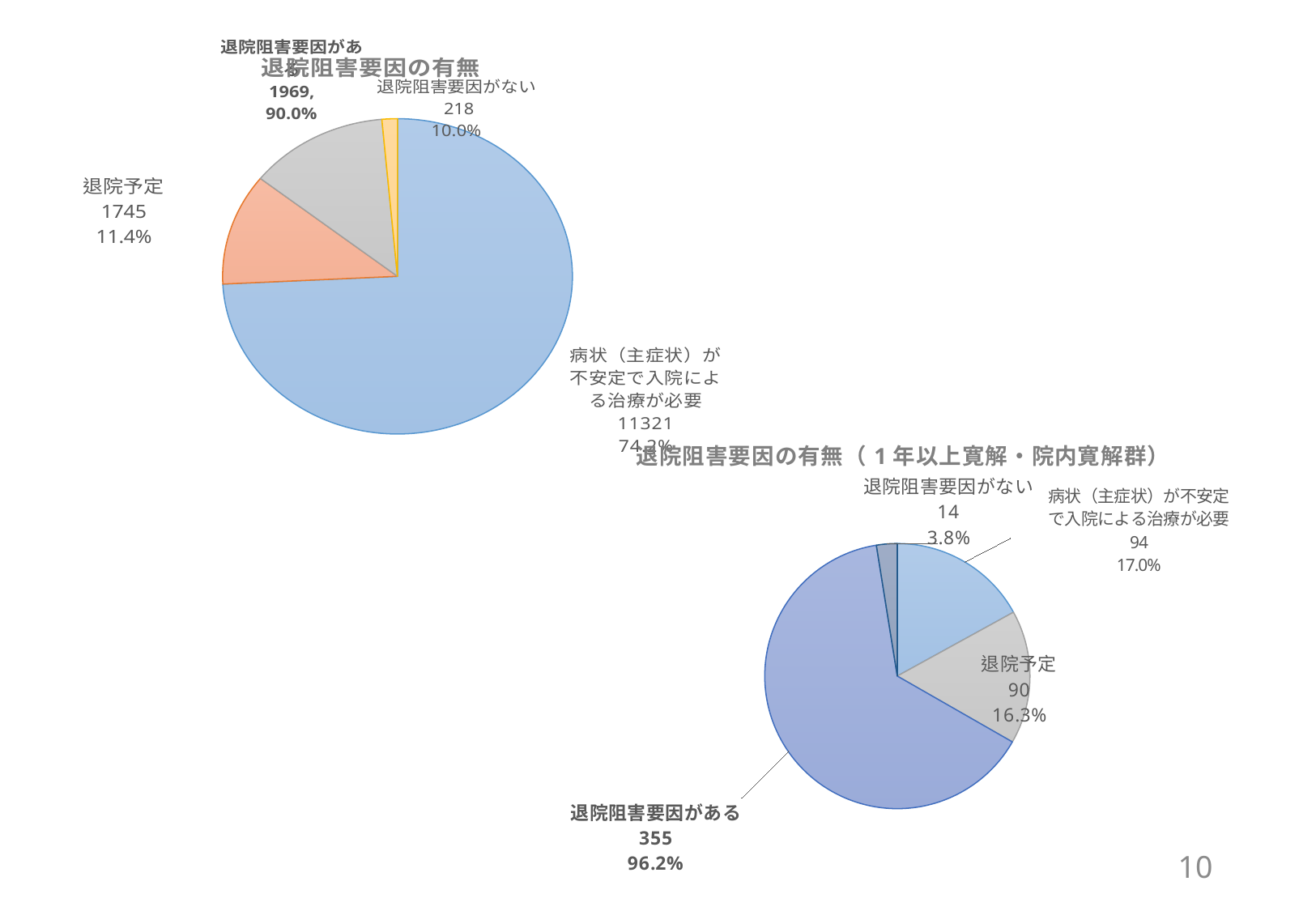
In the chart titled 退院阻害要因の有無（１年以上寛解・院内寛解群）, which slice is the largest? 退院阻害要因がある In the top-left chart titled 退院阻害要因の有無, what is the value for 退院阻害要因がない? 218 In the chart titled 退院阻害要因の有無（１年以上寛解・院内寛解群）, what is the difference between the values for 病状（主症状）が不安定で入院による治療が必要 and 退院予定? 4 In the top-left chart titled 退院阻害要因の有無, what is the value for 病状（主症状）が不安定で入院による治療が必要? 11321 In the chart titled 退院阻害要因の有無（１年以上寛解・院内寛解群）, what is the value for 退院阻害要因がある? 355 In the chart titled 退院阻害要因の有無（１年以上寛解・院内寛解群）, what is the value for 退院予定? 90 In the top-left chart titled 退院阻害要因の有無, which is larger, the value for 退院予定 or the value for 退院阻害要因がない? 退院予定 In the chart titled 退院阻害要因の有無（１年以上寛解・院内寛解群）, what percentage is shown for 退院阻害要因がない? 3.8% In the chart titled 退院阻害要因の有無（１年以上寛解・院内寛解群）, what percentage is shown for 病状（主症状）が不安定で入院による治療が必要? 17.0% In the chart titled 退院阻害要因の有無（１年以上寛解・院内寛解群）, which slice is the smallest? 退院阻害要因がない In the top-left chart titled 退院阻害要因の有無, what is the value for 退院予定? 1745 What type of chart is the chart titled 退院阻害要因の有無（１年以上寛解・院内寛解群）? pie chart